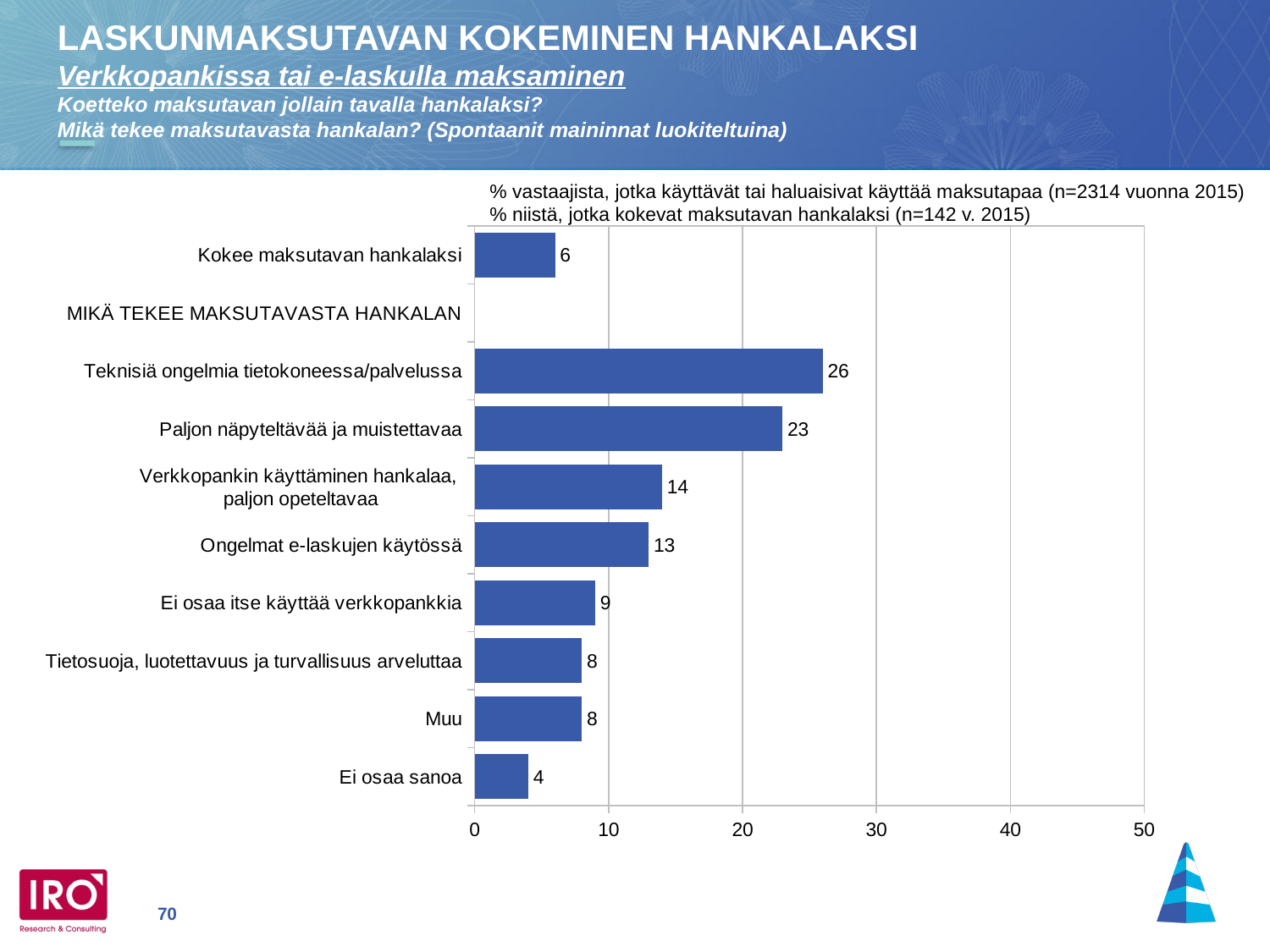
What is the value for "Ei osaa sanoa"? 4 What is the value for "Paljon näpyteltävää ja muistettavaa"? 23 Which category has the lowest value? Ei osaa sanoa Is the value for "Paljon näpyteltävää ja muistettavaa" greater or less than 20? greater What is the value for "Kokee maksutavan hankalaksi"? 6 Which category has the highest value? Teknisiä ongelmia tietokoneessa/palvelussa Which is larger: the value for "Verkkopankin käyttäminen hankalaa, paljon opeteltavaa" or the value for "Ei osaa itse käyttää verkkopankkia"? Verkkopankin käyttäminen hankalaa, paljon opeteltavaa What is the value for "Teknisiä ongelmia tietokoneessa/palvelussa"? 26 What is the value for "Ongelmat e-laskujen käytössä"? 13 How many bars are plotted in the chart? 9 What kind of chart is shown on the slide? Bar chart What is the difference between the values for "Teknisiä ongelmia tietokoneessa/palvelussa" and "Paljon näpyteltävää ja muistettavaa"? 3